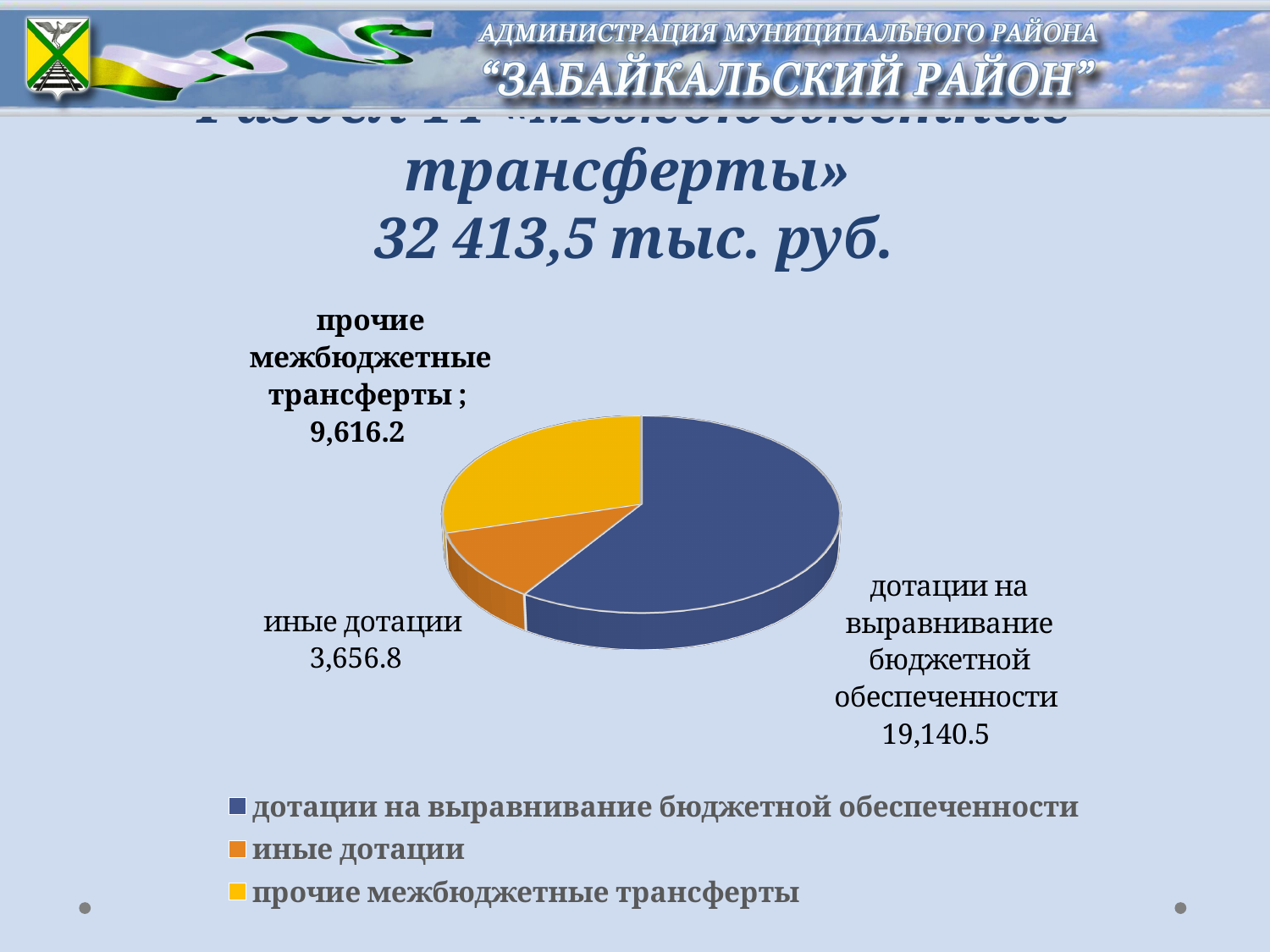
How many slices does the pie chart have? 3 How many entries does the legend list? 3 What kind of chart is shown on the slide? pie chart What is the difference between прочие межбюджетные трансферты and иные дотации? 5,959.4 What colour is the slice for прочие межбюджетные трансферты? yellow Which category has the smallest slice of the pie? иные дотации Which category has the largest slice of the pie? дотации на выравнивание бюджетной обеспеченности What is the difference between дотации на выравнивание бюджетной обеспеченности and иные дотации? 15,483.7 What is the value for дотации на выравнивание бюджетной обеспеченности? 19,140.5 What is the value for прочие межбюджетные трансферты? 9,616.2 What is the value for иные дотации? 3,656.8 Which is larger, прочие межбюджетные трансферты or иные дотации? прочие межбюджетные трансферты